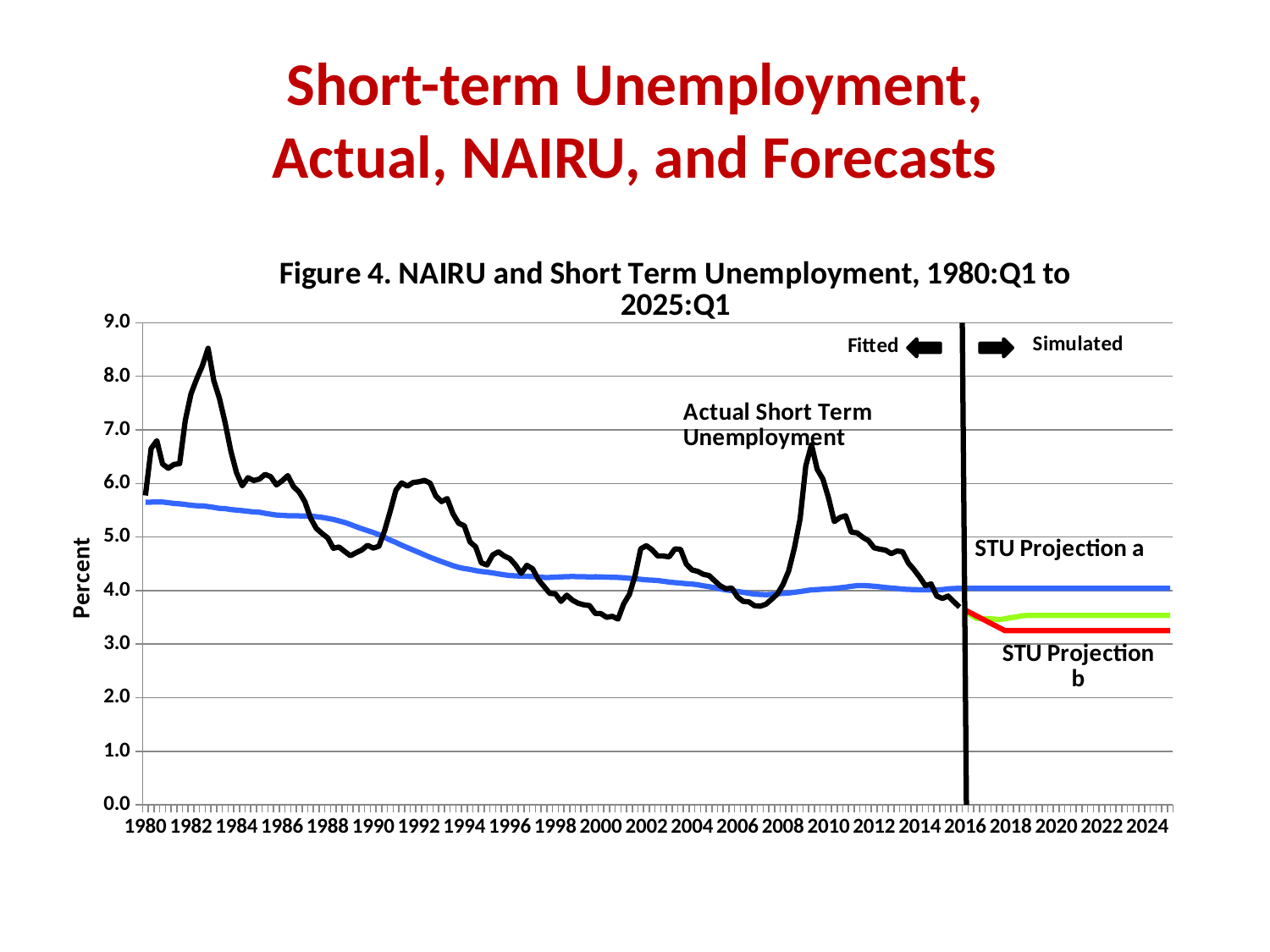
In 2024, which is higher, STU Projection a or STU Projection b? STU Projection a Is the value of STU Projection b in 2024 greater or less than 4.0? less Is the value of the blue NAIRU line in 1980 greater or less than 5.0? greater What is the title of the chart? Figure 4. NAIRU and Short Term Unemployment, 1980:Q1 to 2025:Q1 Does the Actual Short Term Unemployment line reach its highest value before or after 1990? before Is the peak value of the Actual Short Term Unemployment line in the early 1980s greater or less than 8.0? greater What kind of chart is shown on the slide? Line chart What is the label on the vertical axis of the chart? Percent Around 2000, which is higher, the Actual Short Term Unemployment line or the blue NAIRU line? NAIRU Does the blue NAIRU line generally rise or fall from 1980 to 2016? fall